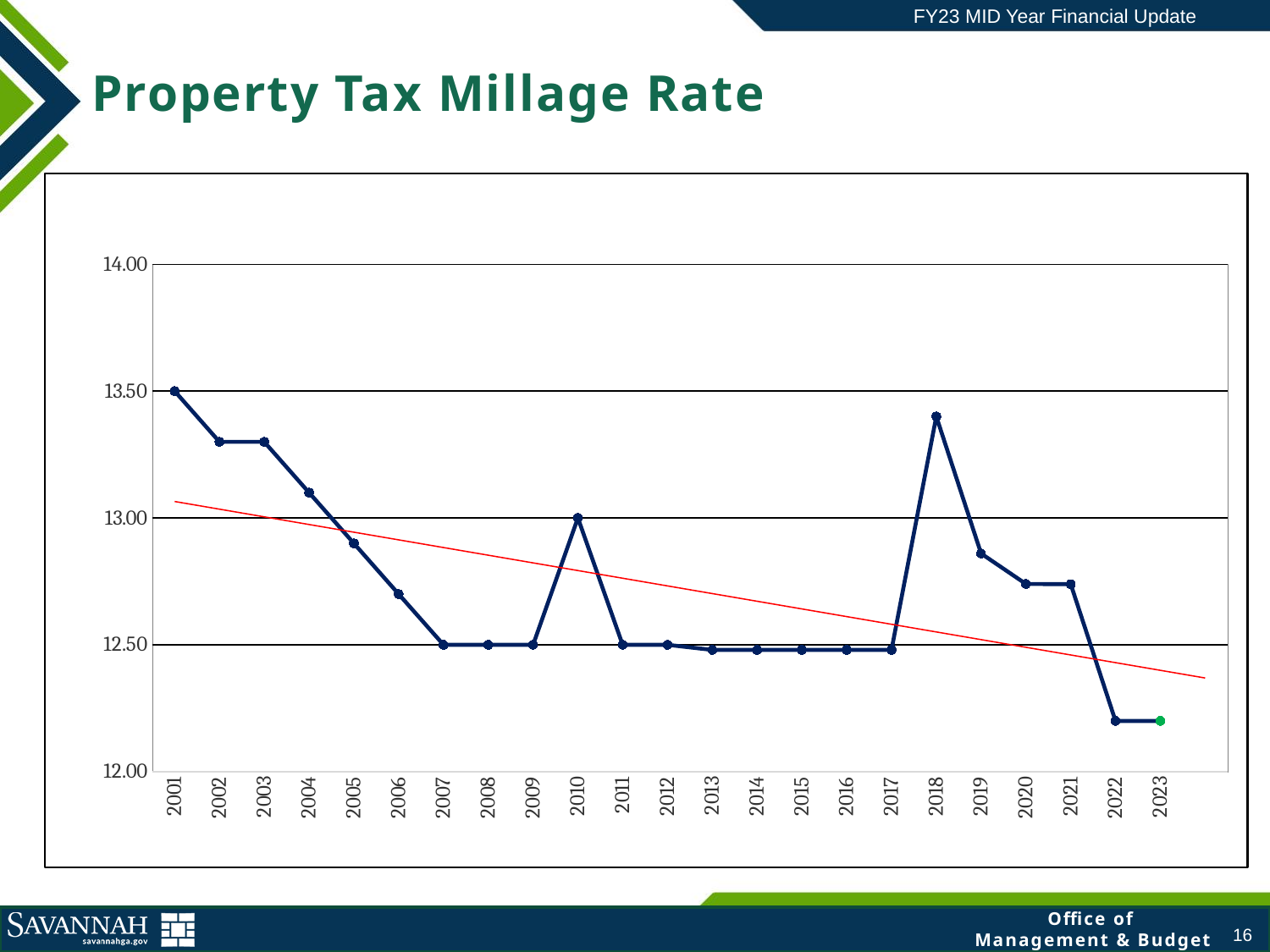
What is the millage rate for 2007? 12.50 Does the millage rate generally rise or fall from 2001 to 2023? fall Which year has the larger millage rate, 2010 or 2018? 2018 What kind of chart is shown on the slide? line chart What is the millage rate for 2001? 13.50 What is the millage rate for 2010? 13.00 Is the value for 2005 greater or less than 13.00? less Is the value for 2022 greater or less than 12.50? less Which year has the highest millage rate? 2001 What is the title of the chart? Property Tax Millage Rate How many years are plotted on the x axis? 23 Is the value for 2018 greater or less than 13.00? greater